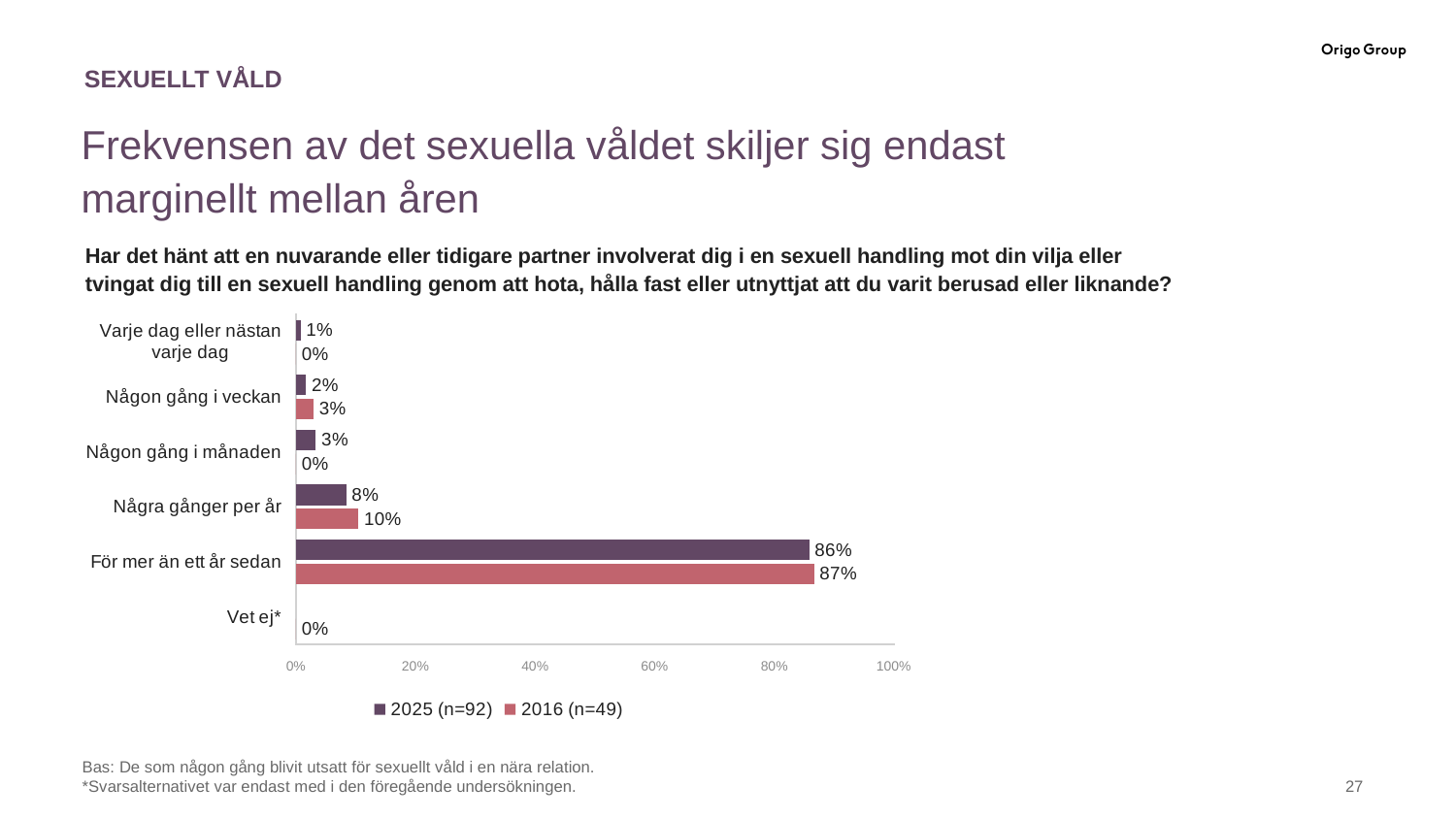
What is the value for "Några gånger per år" in the 2016 (n=49) series? 10% How many categories are shown on the y axis of the chart? 6 What type of chart is shown on the slide? Bar chart What is the value for "Någon gång i månaden" in the 2025 (n=92) series? 3% What is the value for "Någon gång i veckan" in the 2016 (n=49) series? 3% What is the difference between the 2016 (n=49) and 2025 (n=92) values for "Några gånger per år"? 2% Which category has the highest value in the 2025 (n=92) series? För mer än ett år sedan Is the 2025 (n=92) value for "För mer än ett år sedan" greater or less than 80%? greater How many series does the legend list? 2 What are the two series named in the legend? 2025 (n=92) and 2016 (n=49) What is the value for "För mer än ett år sedan" in the 2025 (n=92) series? 86% Which is larger for "För mer än ett år sedan": the 2025 (n=92) value or the 2016 (n=49) value? 2016 (n=49)